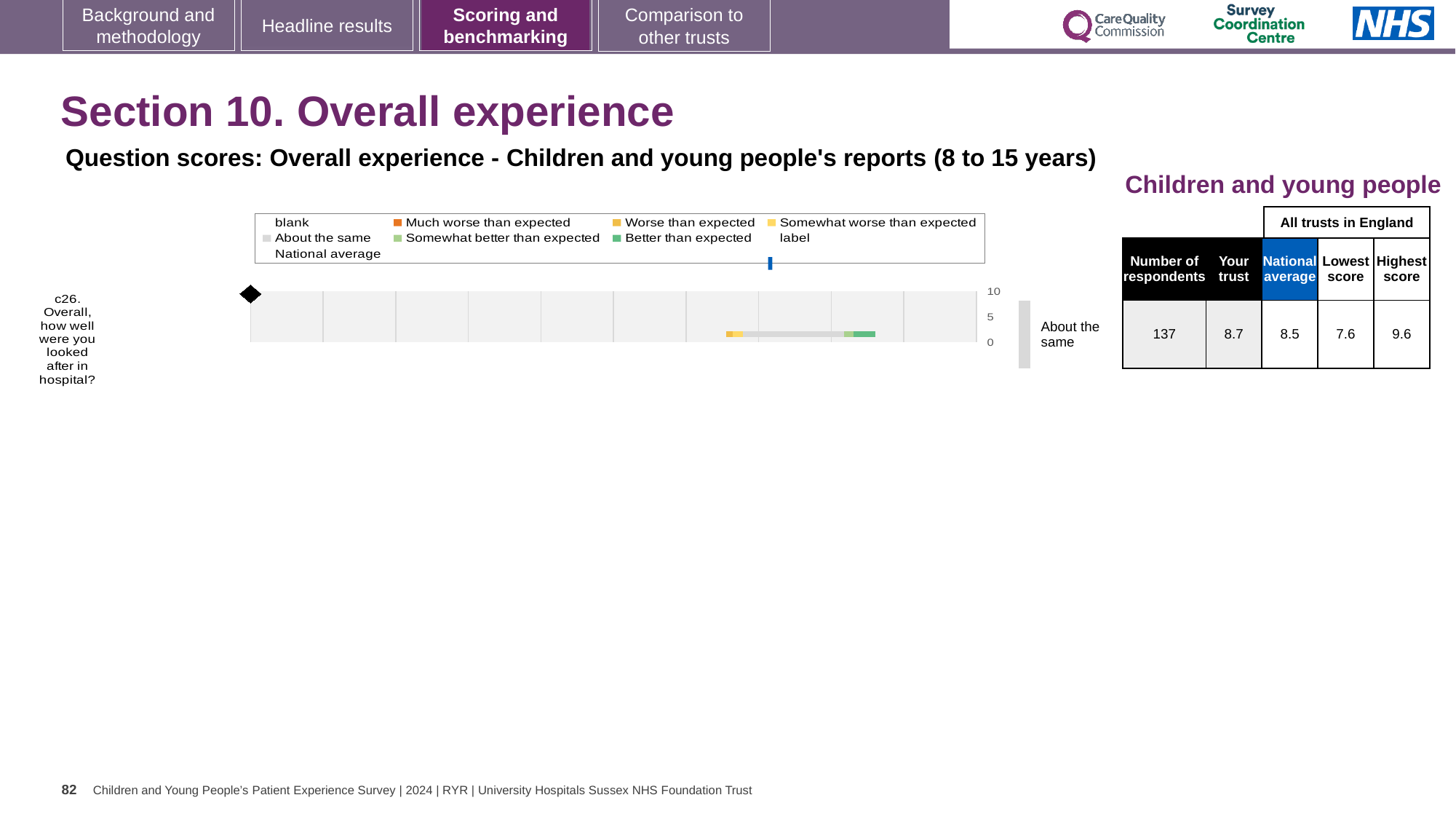
What is the lowest score among all trusts in England for question c26? 7.6 What benchmark category is shown next to the bar for question c26? About the same What kind of chart is used to show the question score for c26? bar chart What is the national average score for question c26? 8.5 What is the difference between the highest score and the lowest score for question c26? 2.0 Which is higher for question c26: the 'Your trust' score or the national average? Your trust What is the maximum value shown on the chart's score axis? 10 By how much does the 'Your trust' score exceed the national average for question c26? 0.2 What is the 'Your trust' score for question c26, 'Overall, how well were you looked after in hospital?' 8.7 How many questions are plotted on the chart? 1 How many respondents answered question c26? 137 What is the highest score among all trusts in England for question c26? 9.6